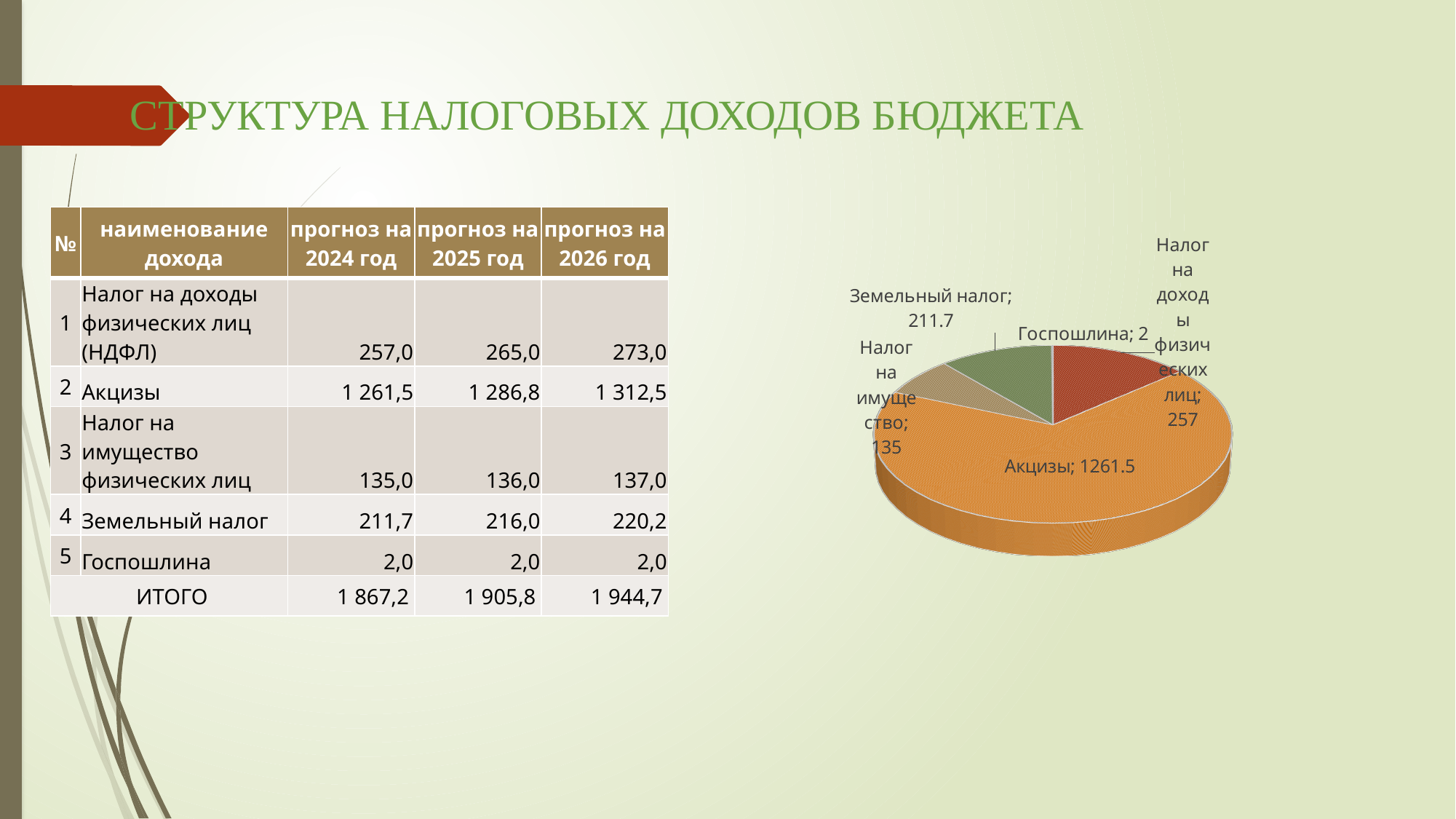
Which slice of the pie chart is the smallest? Госпошлина What value is shown for Налог на доходы физических лиц in the pie chart? 257 What colour is the Акцизы slice in the pie chart? orange What kind of chart is shown on the slide? pie chart In the pie chart, which is larger: Земельный налог or Налог на имущество? Земельный налог What is the difference between the values for Налог на доходы физических лиц and Налог на имущество in the pie chart? 122 What value is shown for Земельный налог in the pie chart? 211.7 What value is shown for Госпошлина in the pie chart? 2 What value is shown for Акцизы in the pie chart? 1261.5 How many slices does the pie chart have? 5 Which slice of the pie chart is the largest? Акцизы What value is shown for Налог на имущество in the pie chart? 135